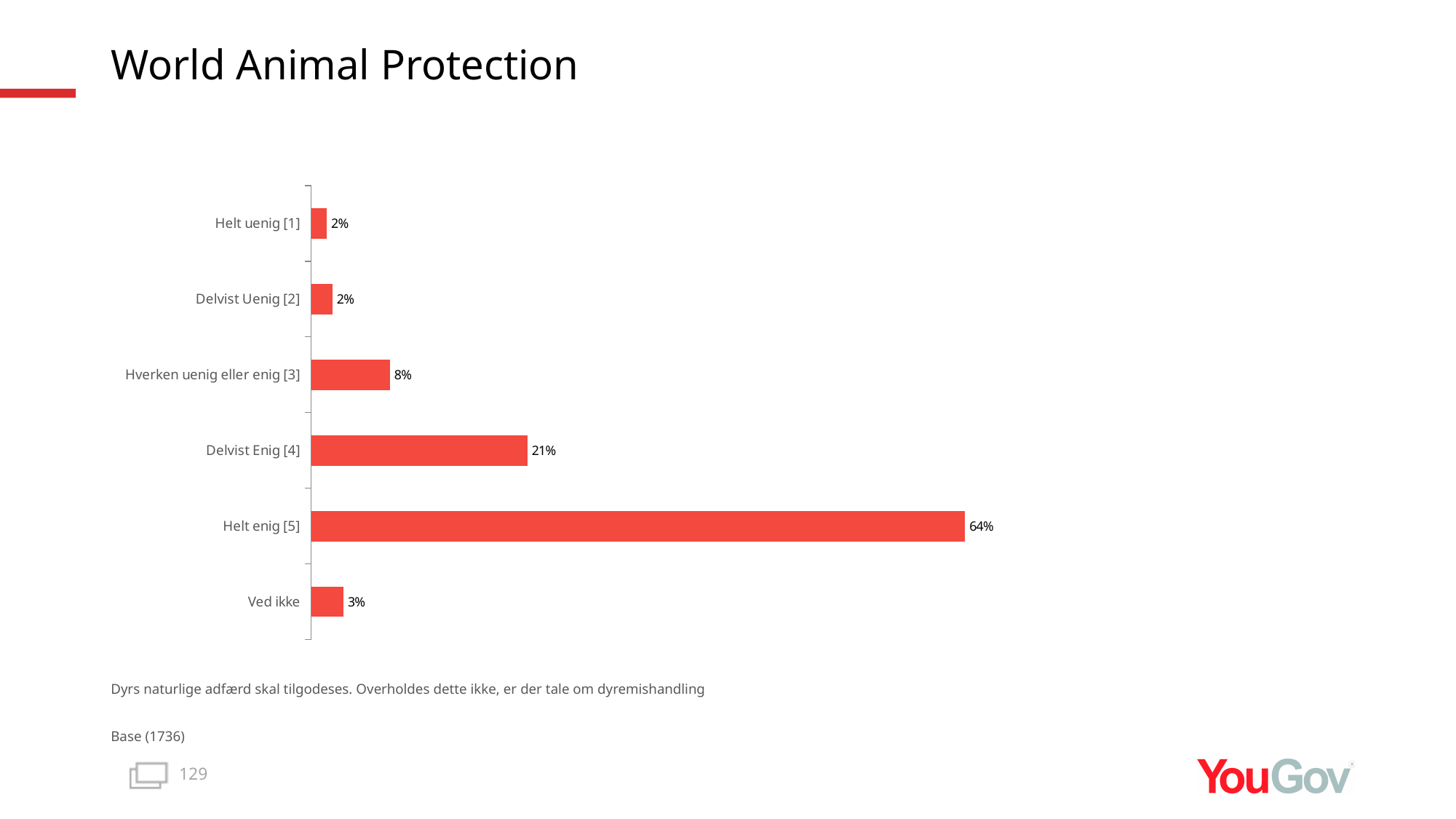
What is the base (number of respondents) stated on the slide? 1736 What is the value for Helt enig [5]? 64% What is the value for Delvist Enig [4]? 21% What is the difference between the values for Delvist Enig [4] and Hverken uenig eller enig [3]? 13% How many categories are shown in the chart? 6 Which is larger, the value for Hverken uenig eller enig [3] or the value for Ved ikke? Hverken uenig eller enig [3] What is the value for Hverken uenig eller enig [3]? 8% What is the value for Ved ikke? 3% What kind of chart is shown on the slide? Bar chart What is the difference between the values for Helt enig [5] and Delvist Enig [4]? 43% What is the value for Helt uenig [1]? 2% Which category has the highest value? Helt enig [5]